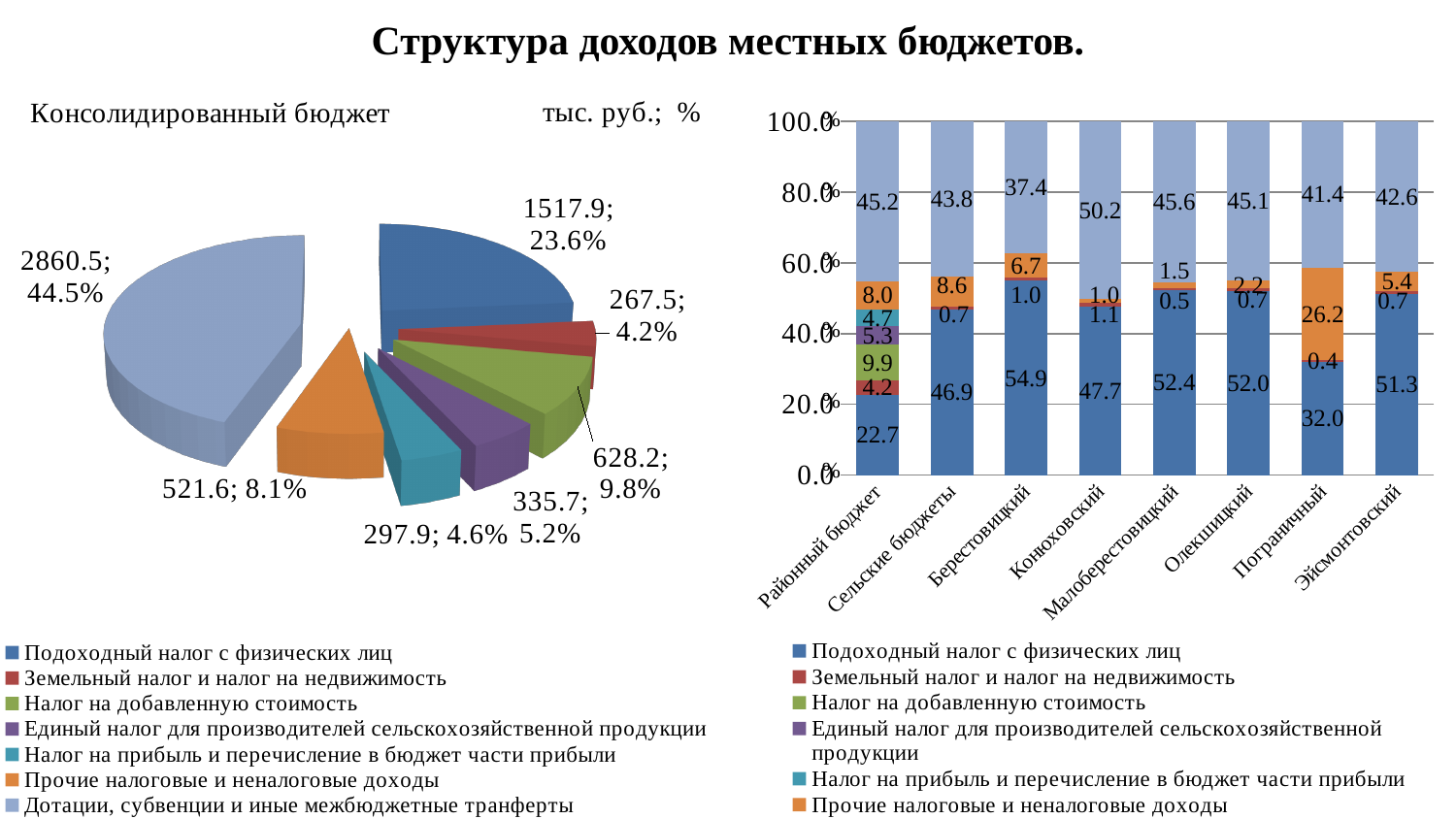
In the stacked bar chart on the right, what is the value of the top (light blue) segment for Коноховский? 50.2 In the stacked bar chart on the right, how many categories are shown on the x axis? 8 In the stacked bar chart on the right, what is the difference between the blue segment values for Сельские бюджеты and Пограничный? 14.9 In the pie chart 'Консолидированный бюджет', what is the difference in percentage points between the 9.8% slice and the 5.2% slice? 4.6 What type of chart is shown on the right side of the slide? stacked bar chart In the stacked bar chart on the right, is the orange segment for Пограничный larger or smaller than the orange segment for Эйсмонтовский? larger In the pie chart 'Консолидированный бюджет', which slice is the smallest? 267.5; 4.2% In the stacked bar chart on the right, what is the value of the bottom (blue) segment for Районный бюджет? 22.7 In the stacked bar chart on the right, which category has the highest value for the bottom (blue) segment? Берестовицкий In the pie chart 'Консолидированный бюджет', how many slices are there? 7 In the pie chart 'Консолидированный бюджет', what share does the slice labelled 1517.9 represent? 23.6% In the pie chart 'Консолидированный бюджет', what value is shown for the largest slice (Дотации, субвенции и иные межбюджетные трансферты)? 2860.5; 44.5%